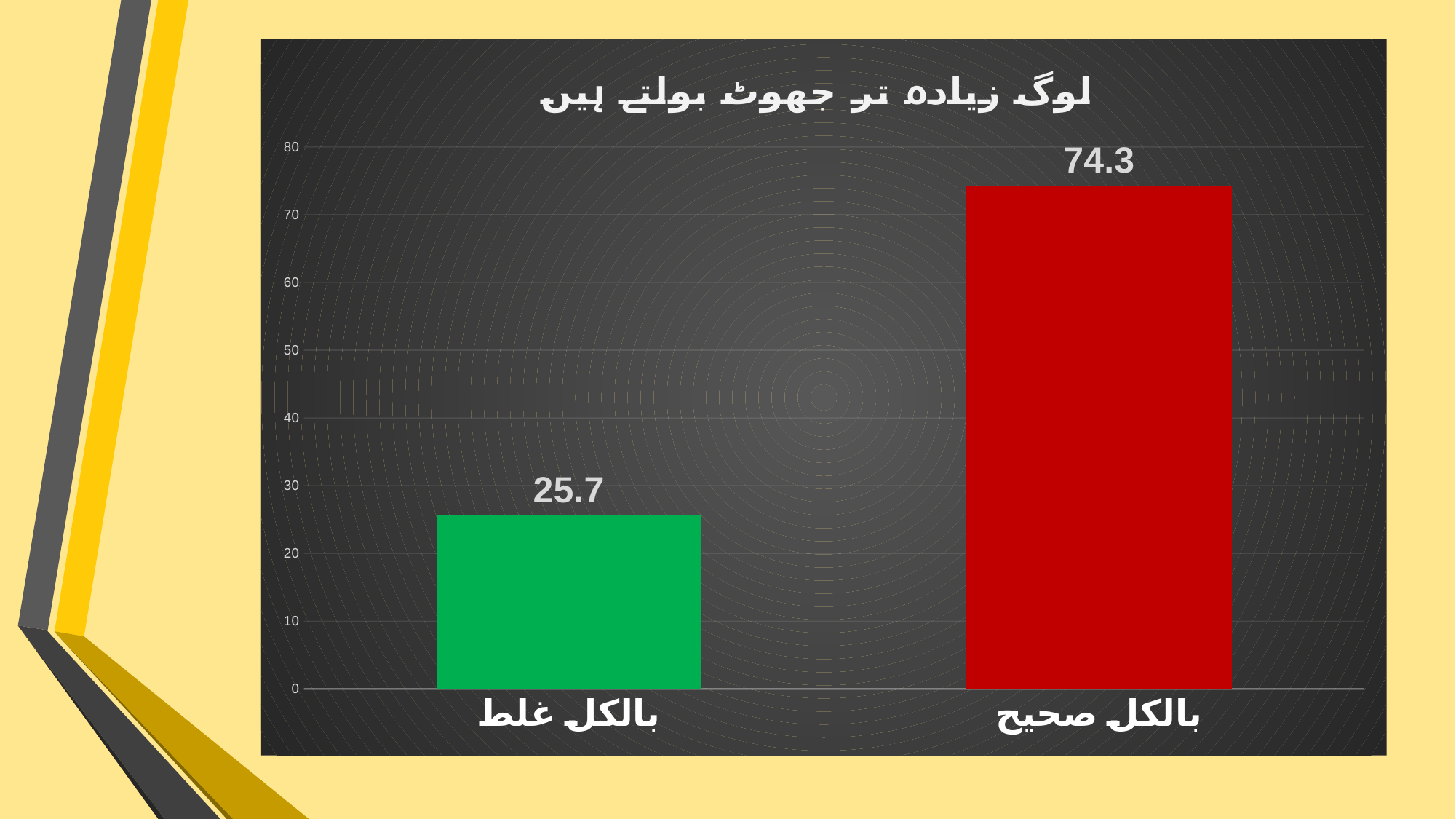
Which category has the lowest value? بالکل غلط How many categories are shown on the x axis? 2 What is the value for بالکل غلط? 25.7 What is the difference between the values for بالکل صحیح and بالکل غلط? 48.6 What is the title of the chart? لوگ زیادہ تر جھوٹ بولتے ہیں Is the value for بالکل غلط greater or less than 30? less What kind of chart is shown on the slide? bar chart What is the value for بالکل صحیح? 74.3 Which category has the highest value? بالکل صحیح Is the value for بالکل صحیح greater or less than 70? greater What colour is the bar for بالکل صحیح? red Which is larger, the value for بالکل غلط or the value for بالکل صحیح? بالکل صحیح